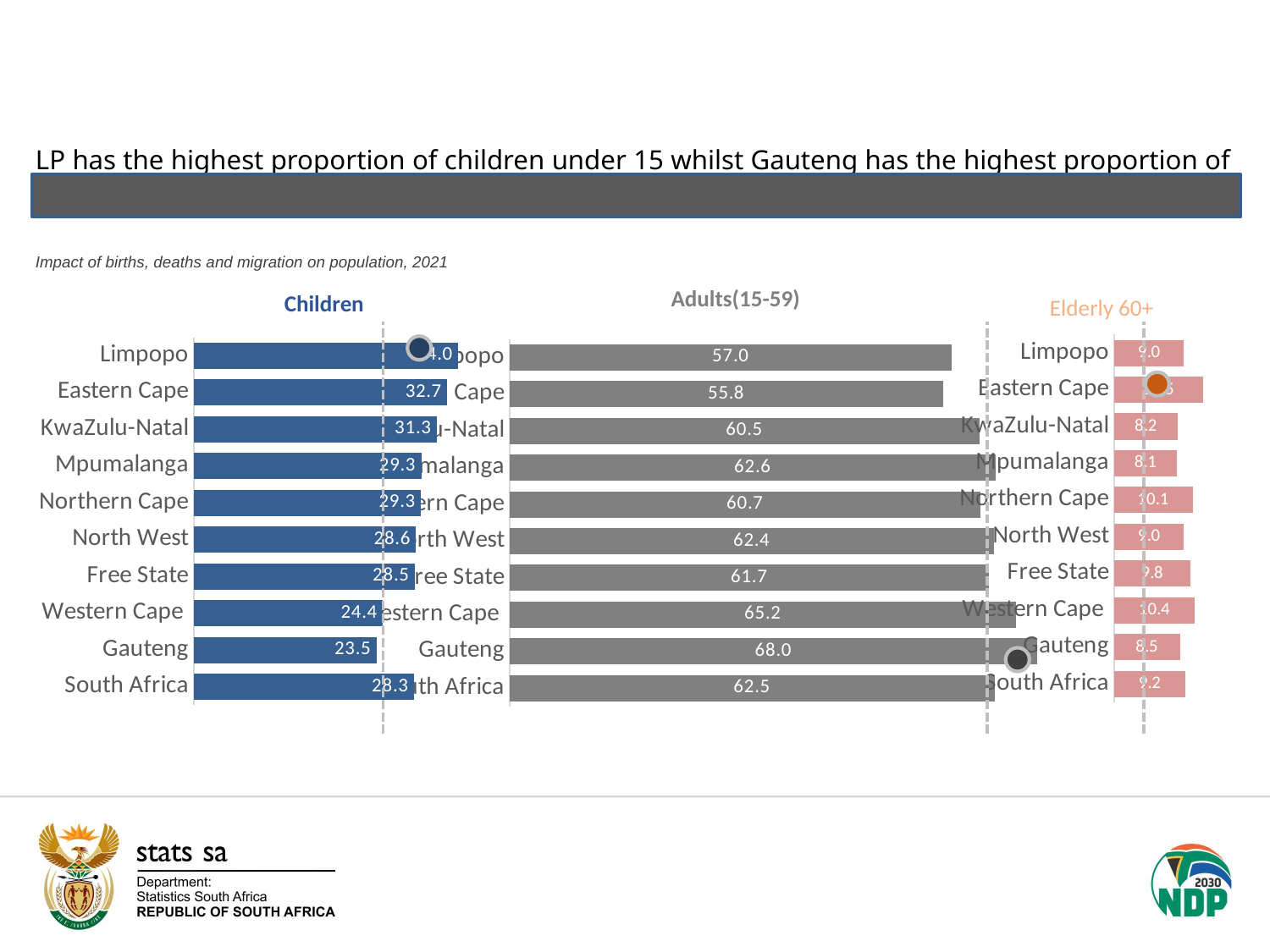
In the Elderly 60+ chart, which is larger, Western Cape or Gauteng? Western Cape In the Children chart, which province has the lowest value? Gauteng In the Adults(15-59) chart, which province has the lowest value? Eastern Cape In the Adults(15-59) chart, which province has the highest value? Gauteng What type of chart is the Children chart? Bar chart In the Children chart, which is larger, Eastern Cape or KwaZulu-Natal? Eastern Cape How many categories are shown in the Adults(15-59) chart? 10 In the Children chart, what is the value for Western Cape? 24.4 In the Adults(15-59) chart, what is the difference between Gauteng and Limpopo? 11.0 In the Adults(15-59) chart, what is the value for Gauteng? 68.0 In the Elderly 60+ chart, what is the value for Northern Cape? 10.1 In the Adults(15-59) chart, what is the value for South Africa? 62.5